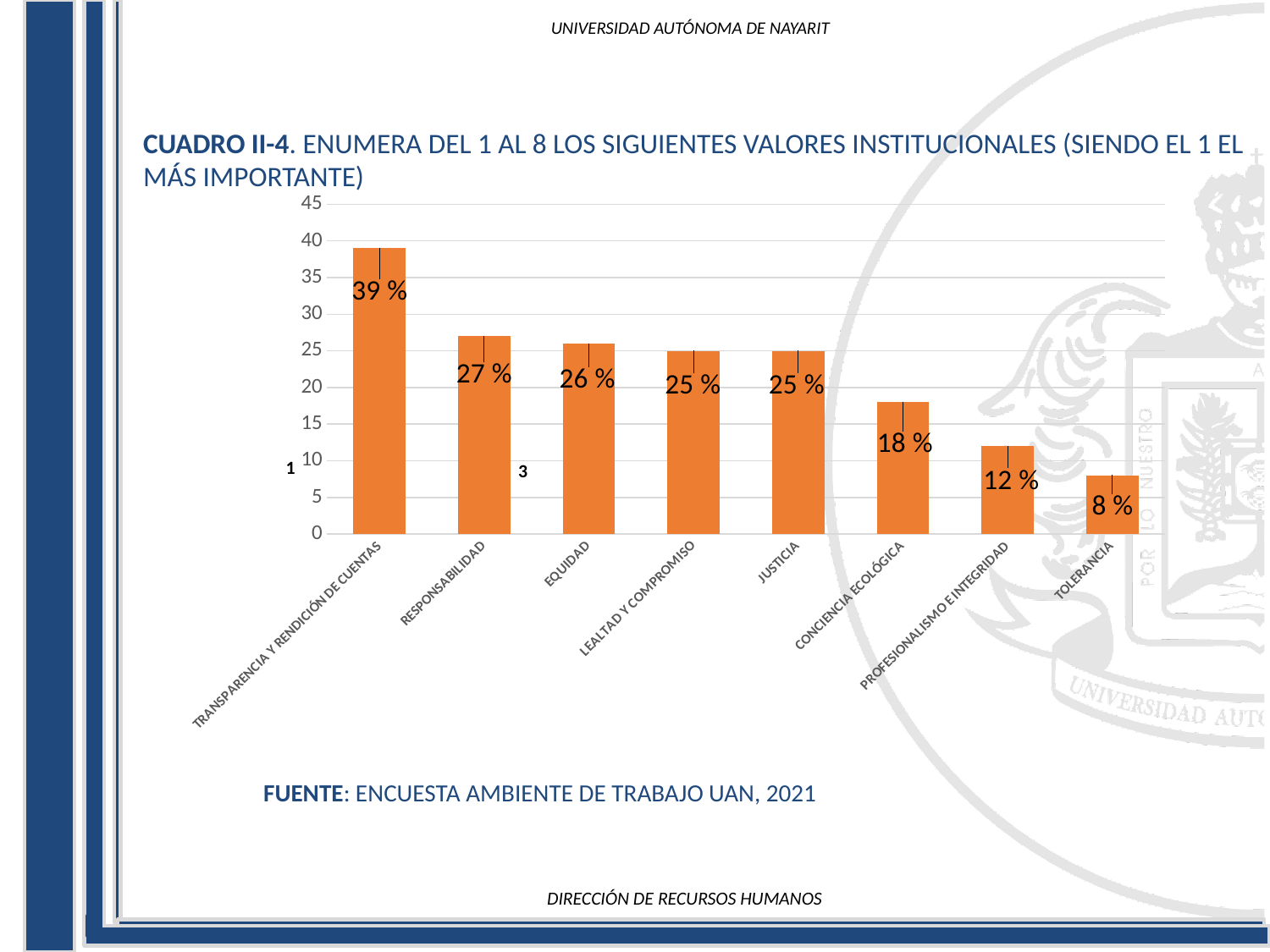
Is the value for JUSTICIA greater or less than 30? less Which is larger, the value for EQUIDAD or the value for CONCIENCIA ECOLÓGICA? EQUIDAD What is the difference between the values for RESPONSABILIDAD and PROFESIONALISMO E INTEGRIDAD? 15 % What is the value for TRANSPARENCIA Y RENDICIÓN DE CUENTAS? 39 % What is the value for TOLERANCIA? 8 % Which category has the lowest value? TOLERANCIA What is the value for CONCIENCIA ECOLÓGICA? 18 % What kind of chart is shown on the slide? bar chart Which category has the highest value? TRANSPARENCIA Y RENDICIÓN DE CUENTAS What is the source cited below the chart? ENCUESTA AMBIENTE DE TRABAJO UAN, 2021 Do the values rise or fall from left to right along the x axis? fall How many categories are shown on the x axis? 8